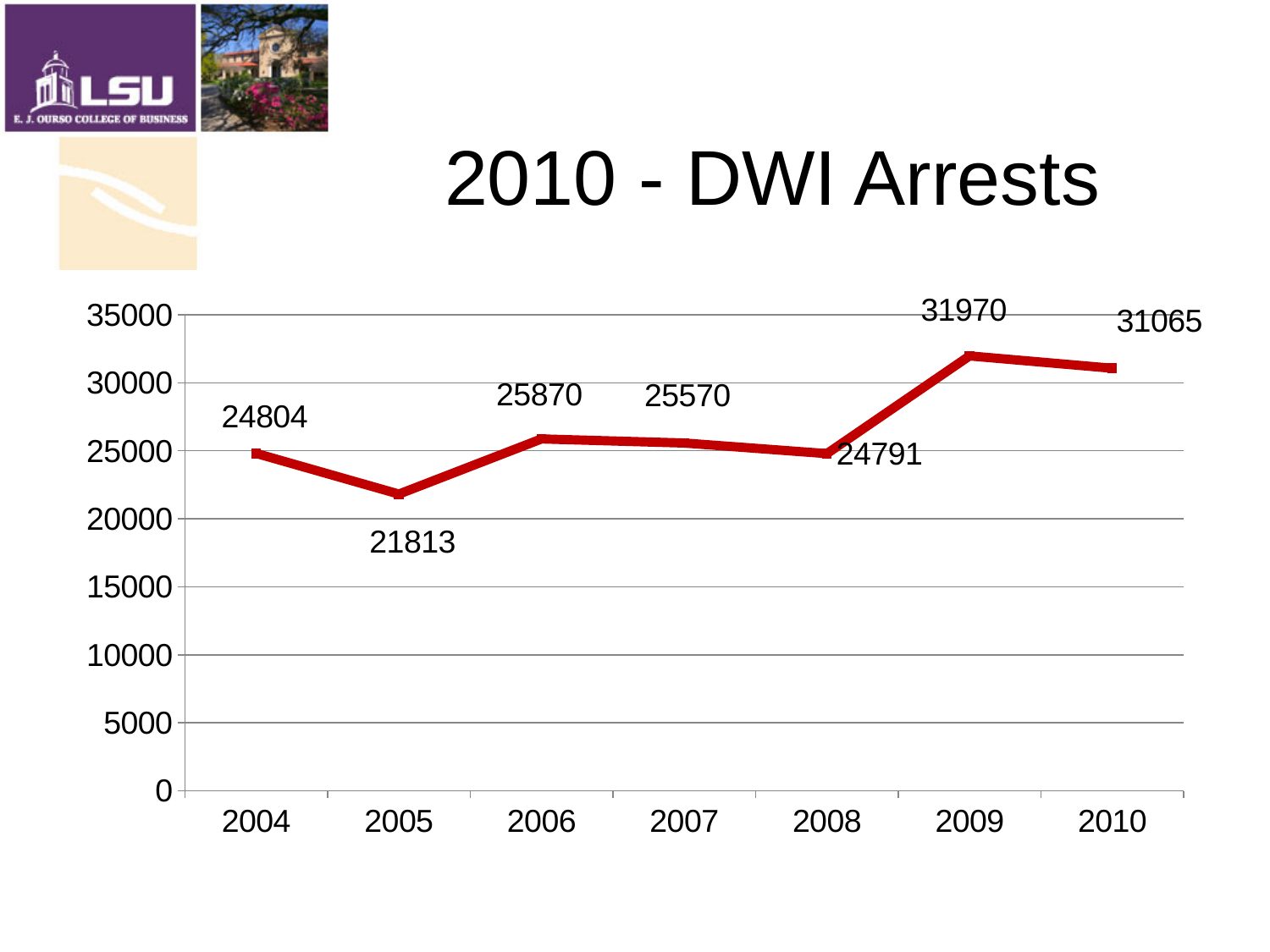
What is the value for 2010? 31065 How many years are plotted on the chart? 7 Which is larger, the value for 2006 or the value for 2007? 2006 Which year has the lowest value? 2005 What is the title of the slide? 2010 - DWI Arrests What is the value for 2009? 31970 What is the difference between the values for 2006 and 2005? 4057 What kind of chart is shown? line chart What is the difference between the values for 2009 and 2010? 905 Is the value for 2008 greater or less than 30000? less Which year has the highest value? 2009 What is the value for 2004? 24804